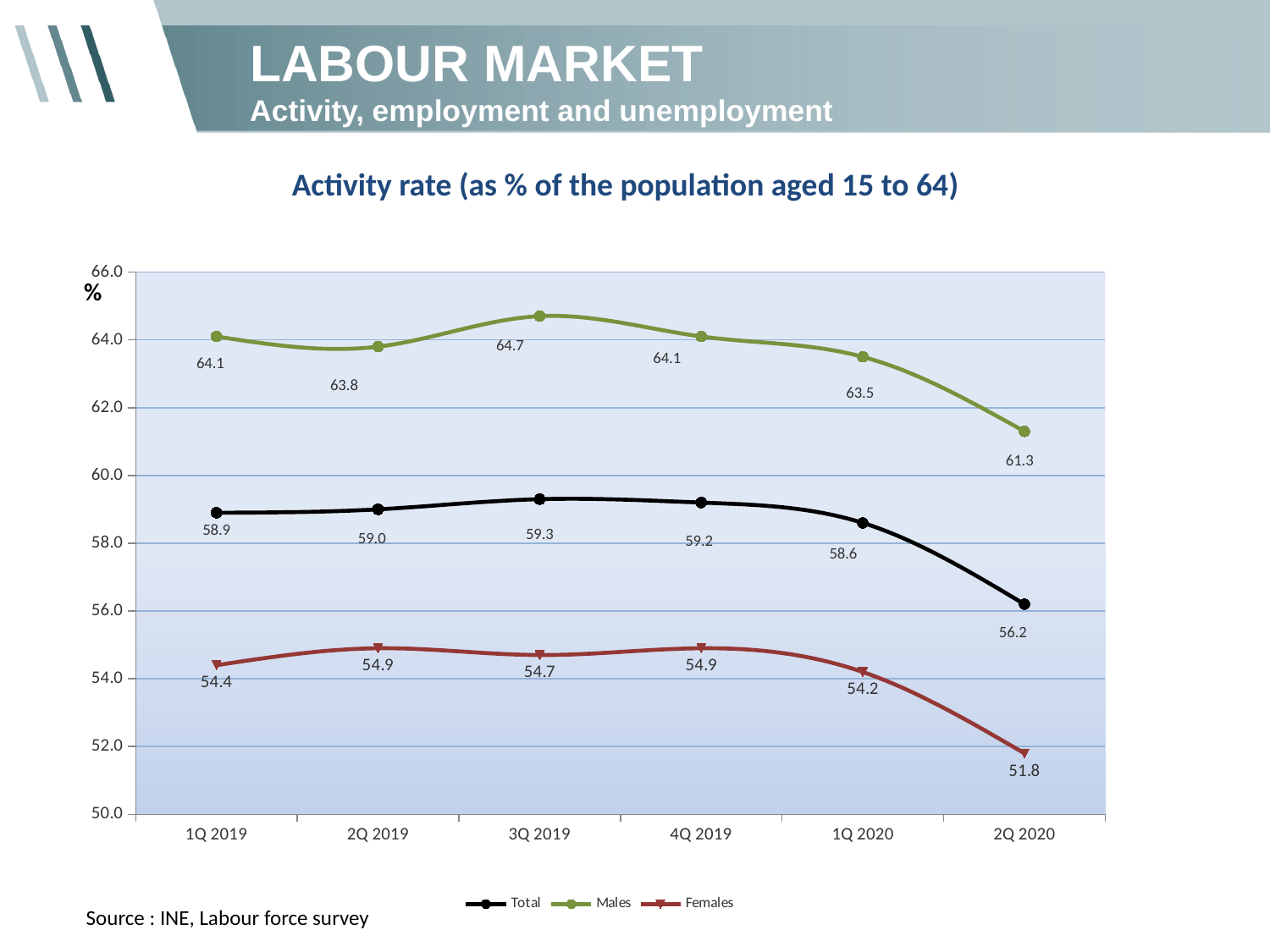
What kind of chart is shown on the slide? line chart Which is larger, the Females activity rate in 2Q 2019 or in 3Q 2019? 2Q 2019 In which quarter is the Males activity rate lowest? 2Q 2020 What is the difference between the Males and Females activity rates in 2Q 2020? 9.5 What is the activity rate for Females in 2Q 2020? 51.8 Is the Males activity rate in 2Q 2020 greater or less than 62.0? less What is the Total activity rate in 1Q 2020? 58.6 How many series does the legend list? 3 What is the activity rate for Males in 3Q 2019? 64.7 How many quarters are shown on the x axis? 6 By how much did the Total activity rate fall from 1Q 2020 to 2Q 2020? 2.4 In which quarter is the Total activity rate highest? 3Q 2019